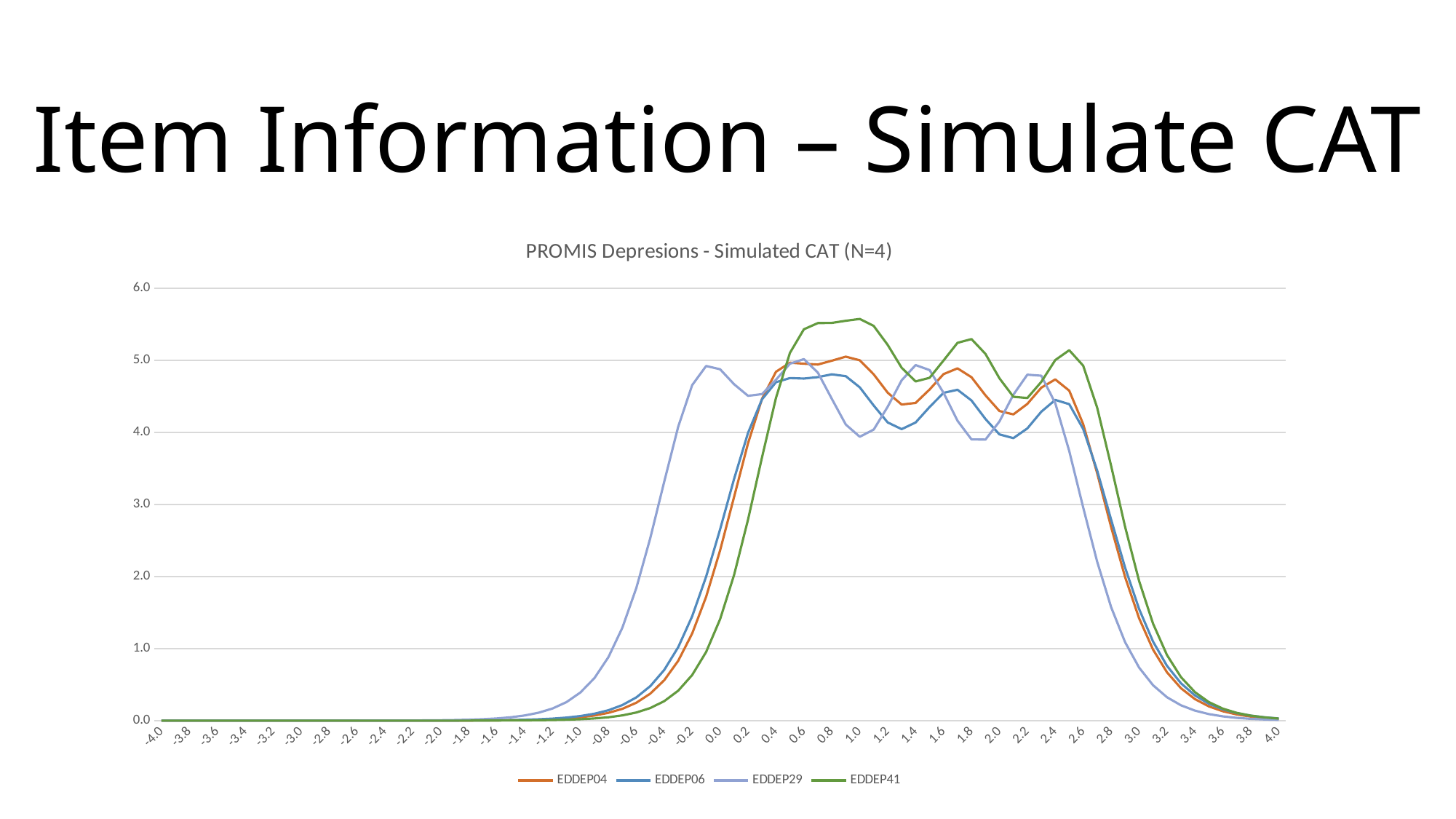
What is the title of the chart? PROMIS Depresions - Simulated CAT (N=4) Which series are listed in the legend? EDDEP04, EDDEP06, EDDEP29, EDDEP41 Is the value for EDDEP04 at -1.0 greater or less than 1.0? less Is the value for EDDEP29 at 3.0 greater or less than 1.0? less What kind of chart is shown on the slide? line chart Which series reaches the highest peak value on the chart? EDDEP41 Is the value for EDDEP41 at 0.8 greater or less than 5.0? greater Between 2.6 and 4.0 on the x axis, do the values of EDDEP04 rise or fall? fall At 1.0 on the x axis, which series has the larger value, EDDEP41 or EDDEP29? EDDEP41 How many series does the legend list? 4